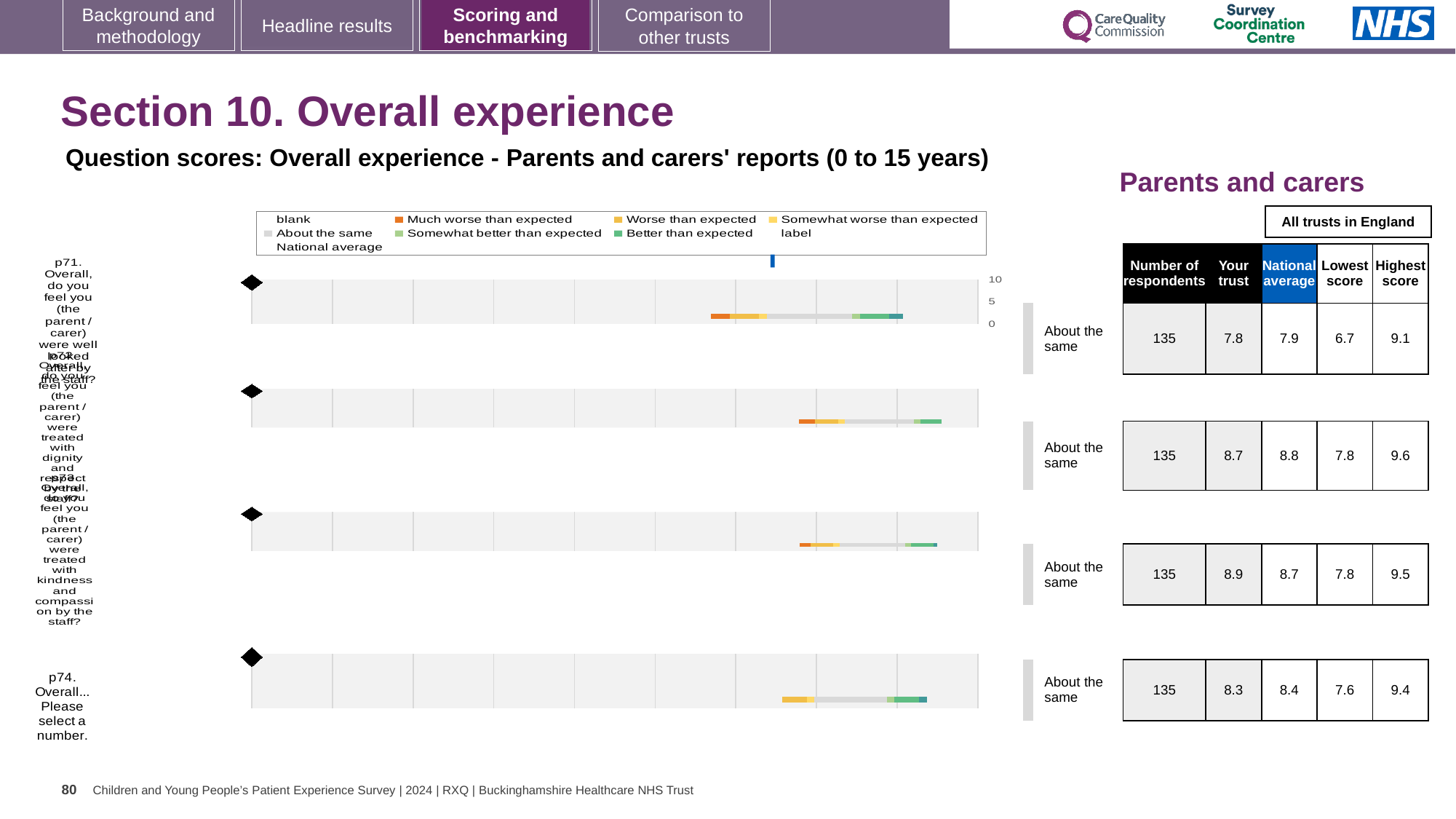
How many question rows (horizontal bars) are plotted in the benchmarking chart? 4 In the table beside the chart, what is the difference between the highest score and the lowest score for the p74 row? 1.8 What is the title of the chart section above the benchmarking bars? Question scores: Overall experience - Parents and carers' reports (0 to 15 years) In the table beside the chart, what is the number of respondents for the p71 row? 135 In the table beside the chart, which row has the lowest 'Your trust' score? the first row, p71 (7.8) In the table beside the chart, what is the 'Your trust' score for the first row (p71, well looked after by the staff)? 7.8 What kind of chart is used to show the question scores on this slide? bar chart In the table beside the chart, what is the national average for the last row (p74, Overall... Please select a number)? 8.4 In the table beside the chart, is the 'Your trust' score for the third row larger or smaller than its national average? larger How many entries does the chart legend list? 9 Which legend entry is shown in orange in the chart legend? Much worse than expected In the table beside the chart, which row has the highest 'Your trust' score? the third row (8.9)